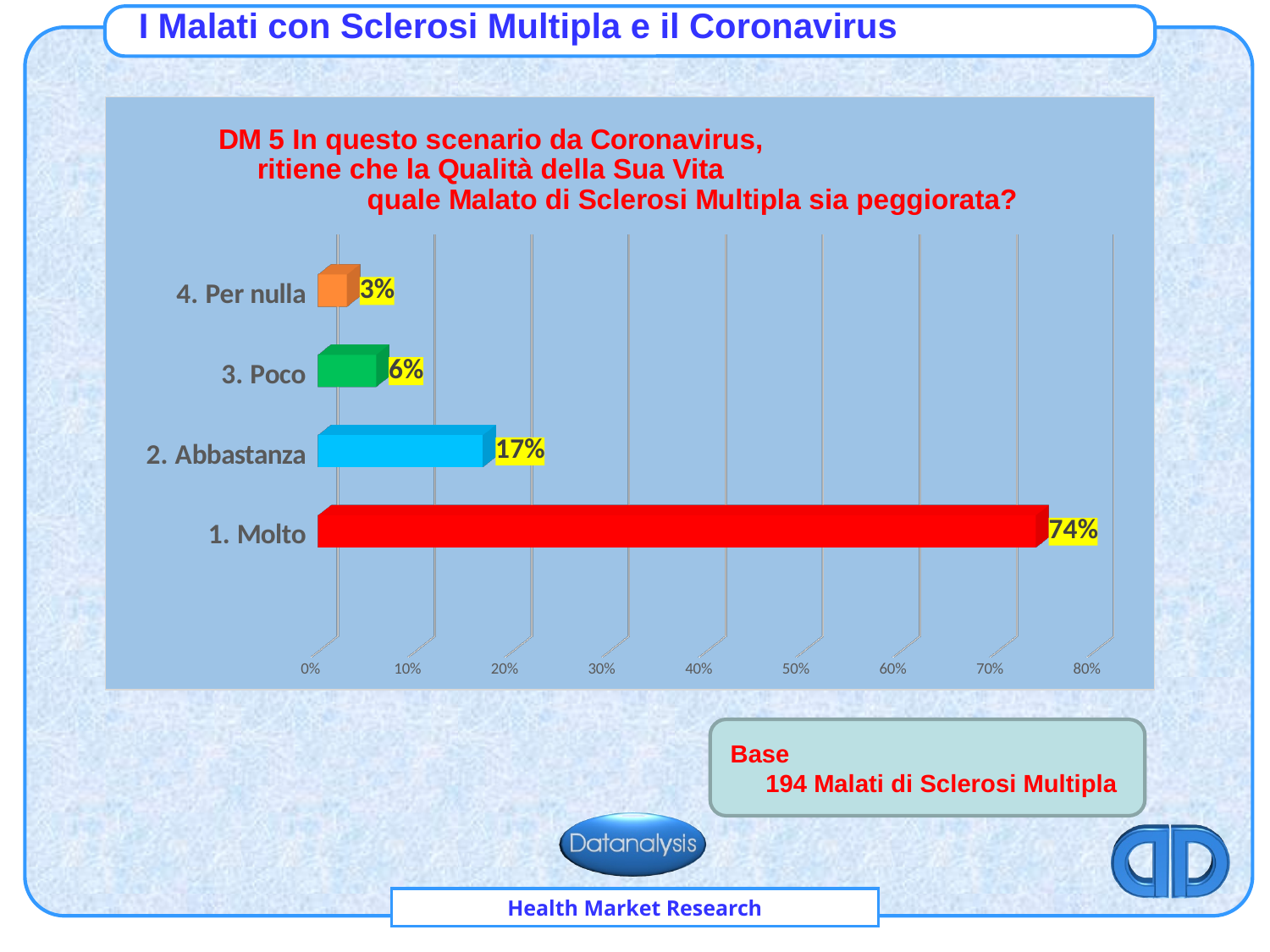
How many categories are shown in the chart? 4 Which is larger, the value for "3. Poco" or the value for "4. Per nulla"? 3. Poco What is the value for "4. Per nulla"? 3% What colour is the bar for "1. Molto"? red What is the value for "2. Abbastanza"? 17% Is the value for "1. Molto" greater or less than 70%? greater Which category has the lowest value? 4. Per nulla What is the value for "1. Molto"? 74% What is the difference between the values for "1. Molto" and "2. Abbastanza"? 57% What kind of chart is shown on the slide? bar chart Which category has the highest value? 1. Molto What is the value for "3. Poco"? 6%